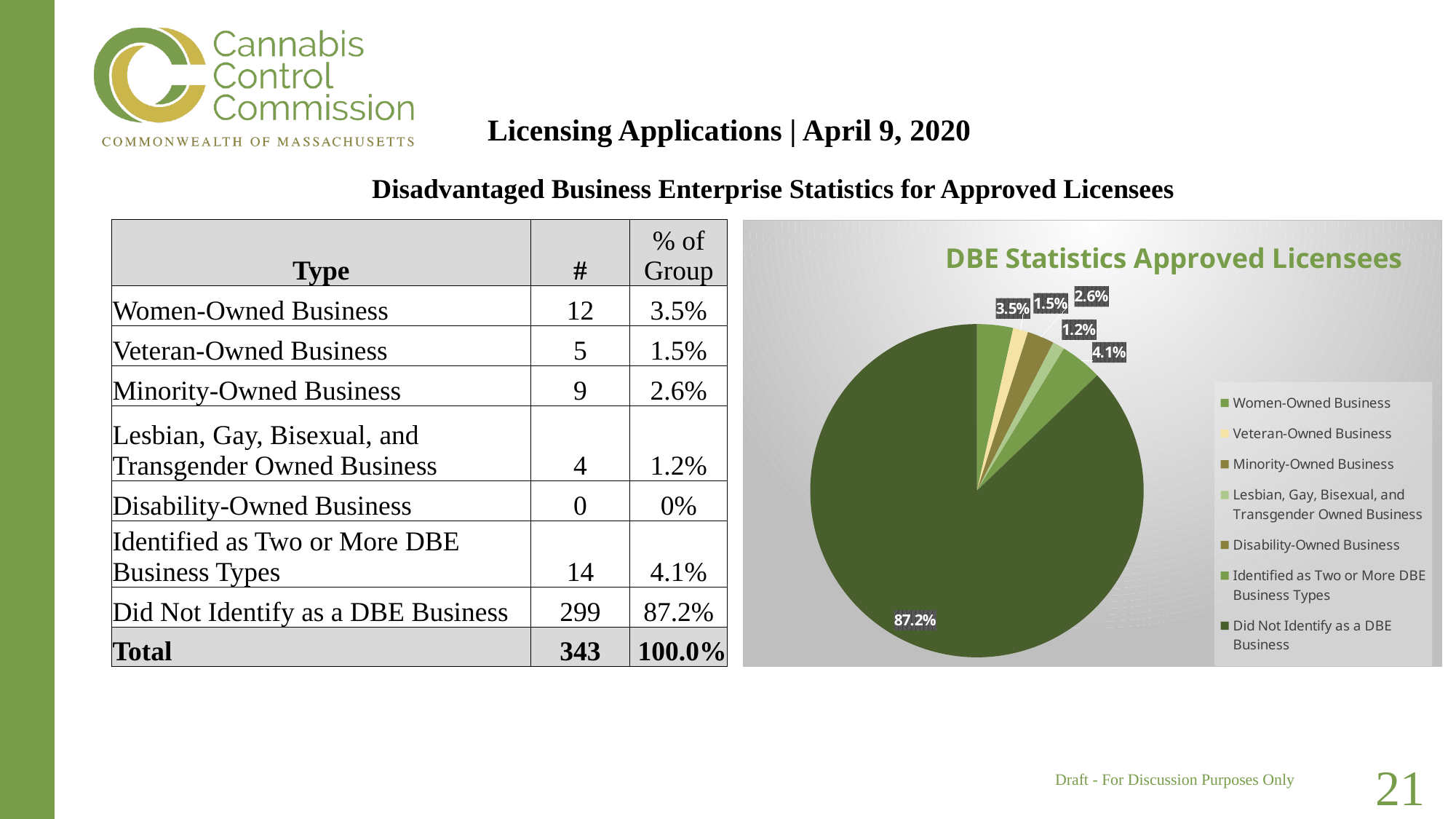
What share of the pie is labelled for Lesbian, Gay, Bisexual, and Transgender Owned Business? 1.2% What is the difference between the Identified as Two or More DBE Business Types share and the Women-Owned Business share in the pie chart? 0.6% Which is larger in the pie chart, the Women-Owned Business slice or the Minority-Owned Business slice? Women-Owned Business What kind of chart is shown on the slide? pie chart Which category has the largest slice of the pie? Did Not Identify as a DBE Business What share of the pie is labelled for Women-Owned Business? 3.5% What share of the pie is labelled for Identified as Two or More DBE Business Types? 4.1% How many entries does the chart's legend list? 7 What is the title of the chart? DBE Statistics Approved Licensees